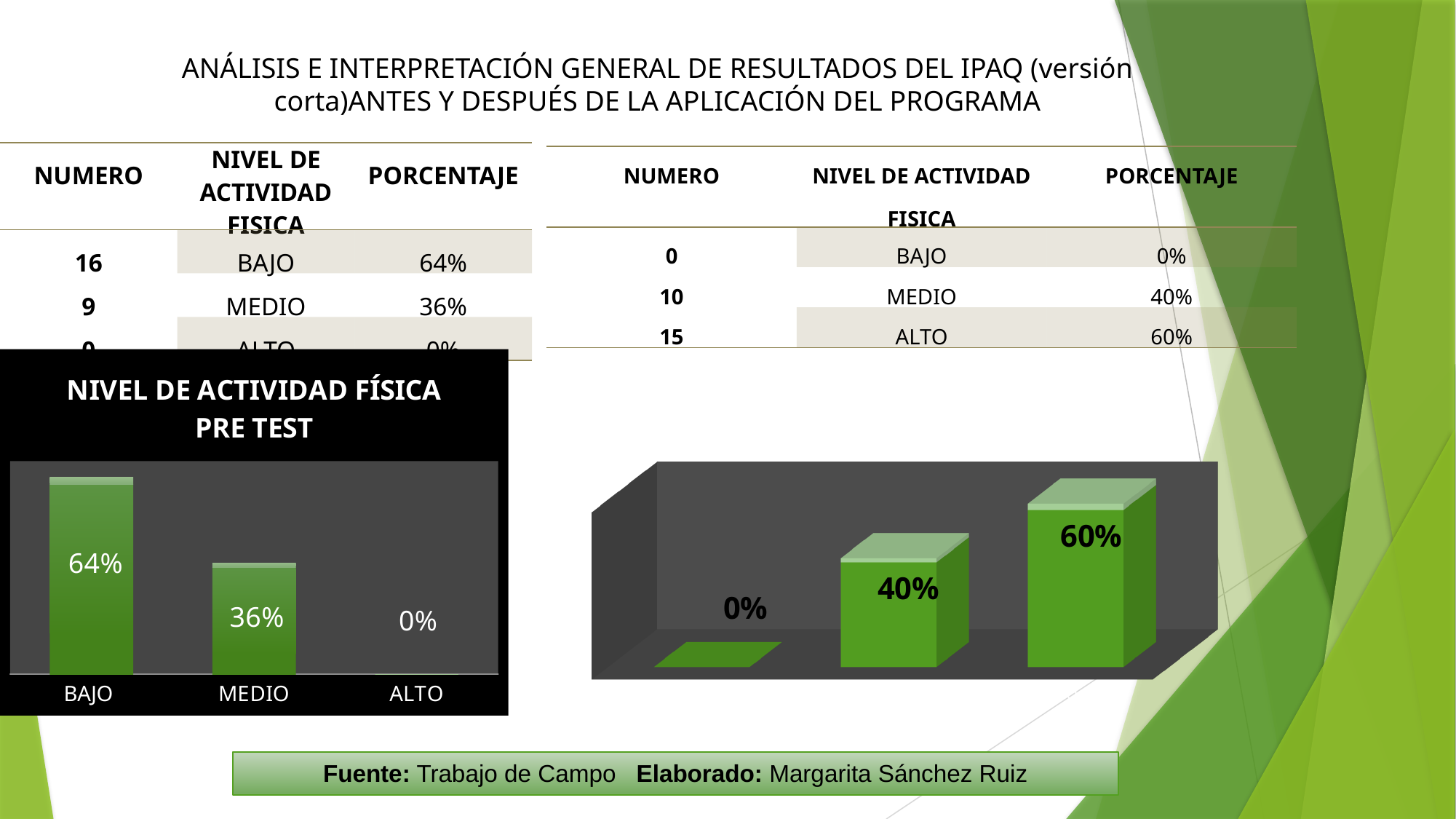
In the chart titled NIVEL DE ACTIVIDAD FÍSICA PRE TEST, what is the value for ALTO? 0% In the chart on the lower right of the slide, what is the difference between the values of the rightmost bar and the middle bar? 20% In the chart titled NIVEL DE ACTIVIDAD FÍSICA PRE TEST, how many categories are shown on the x axis? 3 In the chart titled NIVEL DE ACTIVIDAD FÍSICA PRE TEST, which category has the highest value? BAJO In the chart titled NIVEL DE ACTIVIDAD FÍSICA PRE TEST, what is the value for BAJO? 64% In the chart titled NIVEL DE ACTIVIDAD FÍSICA PRE TEST, what is the difference between the values for BAJO and MEDIO? 28% In the chart titled NIVEL DE ACTIVIDAD FÍSICA PRE TEST, which category has the lowest value? ALTO In the chart on the lower right of the slide, what is the value labelled on the middle bar? 40% In the chart titled NIVEL DE ACTIVIDAD FÍSICA PRE TEST, do the values rise or fall from left to right? fall In the chart titled NIVEL DE ACTIVIDAD FÍSICA PRE TEST, what is the value for MEDIO? 36% What kind of chart is the one titled NIVEL DE ACTIVIDAD FÍSICA PRE TEST? bar chart In the chart on the lower right of the slide, what is the value labelled on the tallest bar? 60%